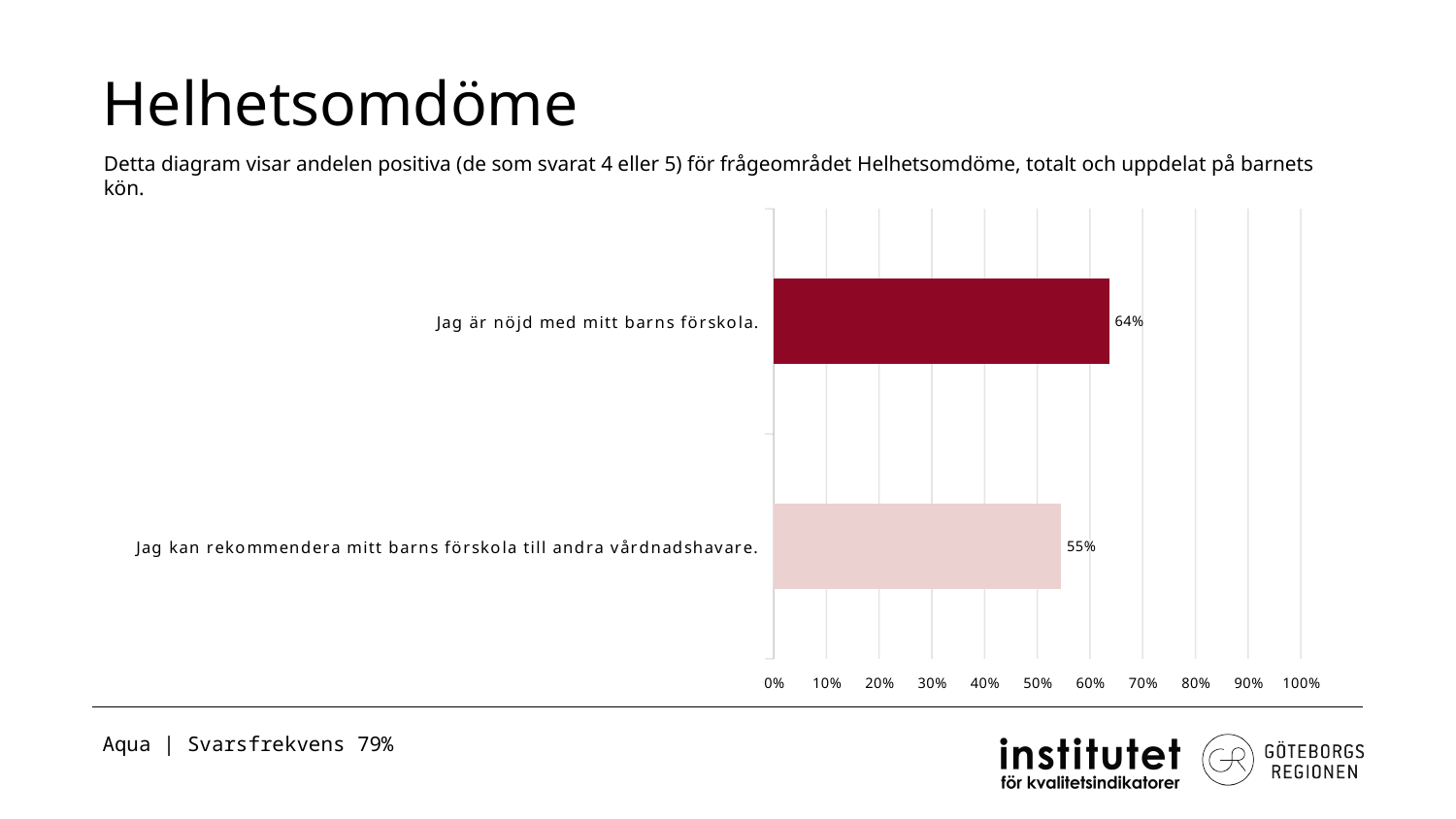
What is the maximum value shown on the x axis? 100% What is the difference between the values for "Jag är nöjd med mitt barns förskola." and "Jag kan rekommendera mitt barns förskola till andra vårdnadshavare."? 9% What kind of chart is shown on the slide? Bar chart Which category has the highest value? Jag är nöjd med mitt barns förskola. Is the value for "Jag är nöjd med mitt barns förskola." greater or less than 60%? greater What is the value for "Jag kan rekommendera mitt barns förskola till andra vårdnadshavare."? 55% What is the title of the slide containing the chart? Helhetsomdöme Which is larger: the value for "Jag är nöjd med mitt barns förskola." or for "Jag kan rekommendera mitt barns förskola till andra vårdnadshavare."? Jag är nöjd med mitt barns förskola. What is the value for "Jag är nöjd med mitt barns förskola."? 64% Which category has the lowest value? Jag kan rekommendera mitt barns förskola till andra vårdnadshavare. Is the value for "Jag kan rekommendera mitt barns förskola till andra vårdnadshavare." greater or less than 60%? less How many categories are shown in the chart? 2